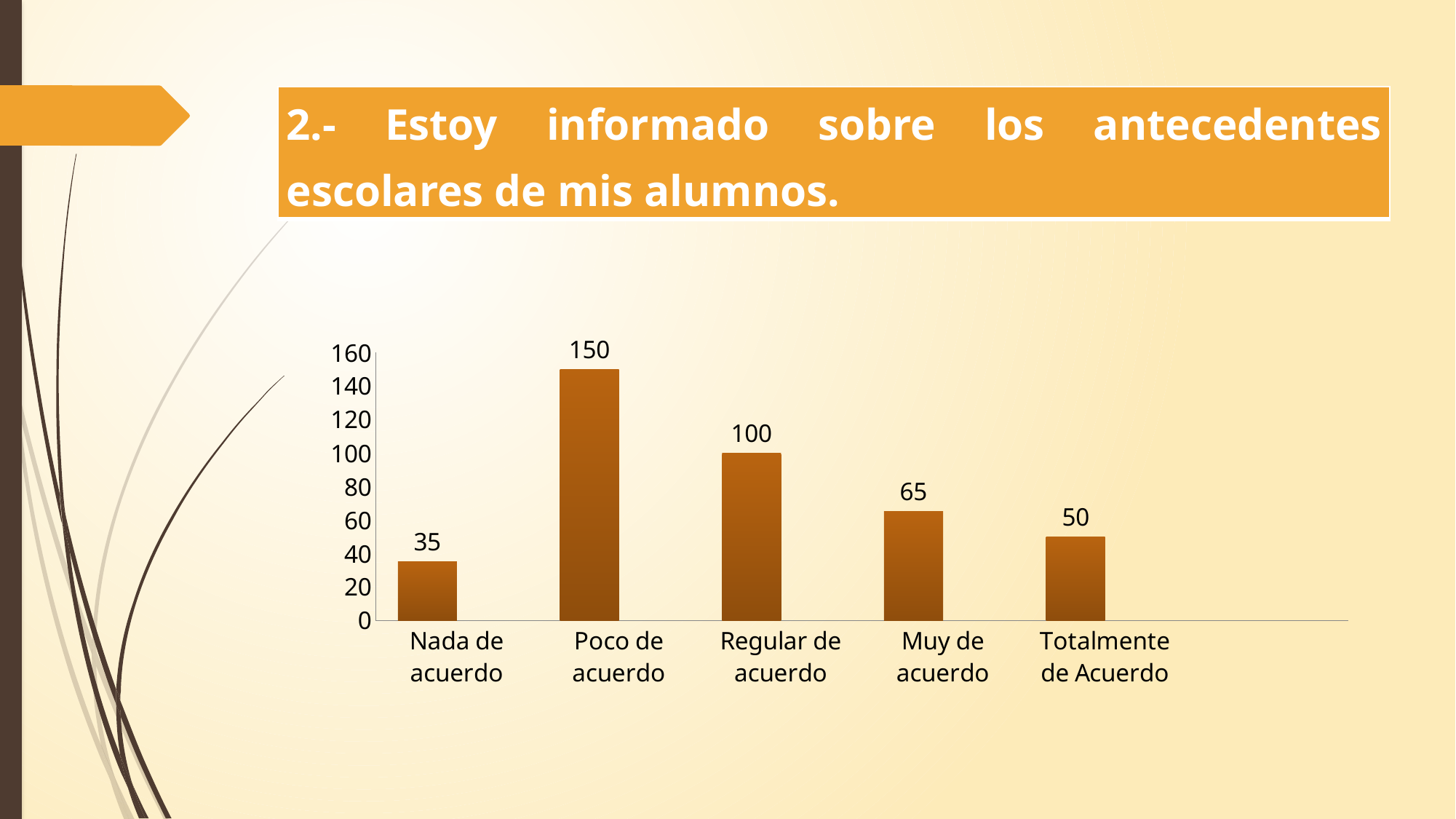
Which is larger, the value for "Muy de acuerdo" or the value for "Totalmente de Acuerdo"? Muy de acuerdo Which category has the highest value? Poco de acuerdo What is the difference between the values for "Poco de acuerdo" and "Regular de acuerdo"? 50 What kind of chart is shown on the slide? bar chart How many categories are shown on the x axis? 5 What is the value for "Poco de acuerdo"? 150 Is the value for "Regular de acuerdo" greater or less than 120? less Which category has the lowest value? Nada de acuerdo What is the title text shown above the chart? 2.- Estoy informado sobre los antecedentes escolares de mis alumnos. What is the value for "Totalmente de Acuerdo"? 50 What is the value for "Nada de acuerdo"? 35 What is the value for "Muy de acuerdo"? 65